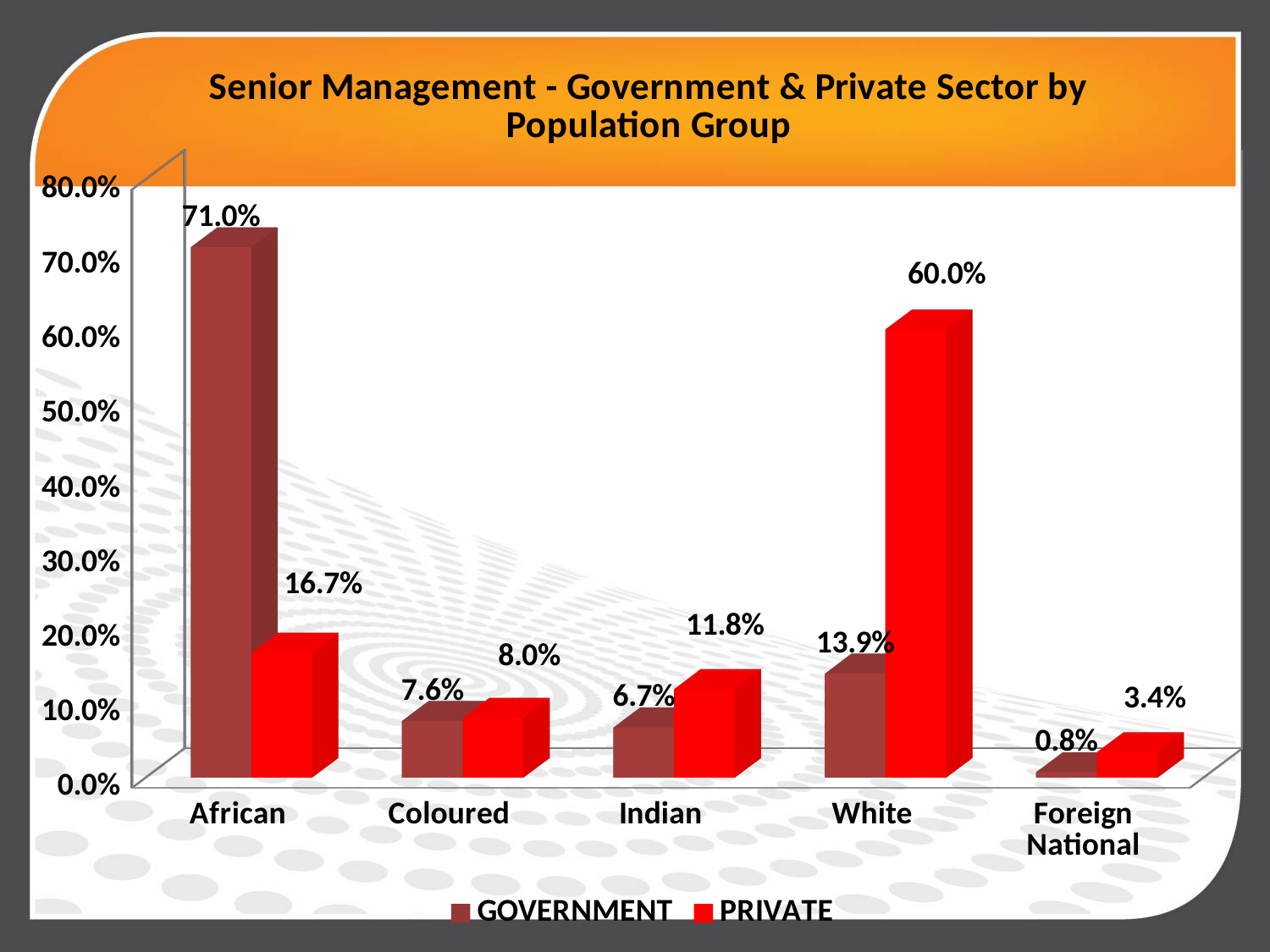
Which population group has the highest GOVERNMENT value? African How many series does the legend list? 2 What is the GOVERNMENT value for African? 71.0% What kind of chart is shown on the slide? Bar chart Which is larger for White: the GOVERNMENT value or the PRIVATE value? PRIVATE What is the title of the chart? Senior Management - Government & Private Sector by Population Group What is the PRIVATE value for White? 60.0% Which population group has the lowest PRIVATE value? Foreign National How many population groups are shown on the x axis? 5 What is the PRIVATE value for Foreign National? 3.4% What is the difference between the GOVERNMENT and PRIVATE values for African? 54.3% What is the GOVERNMENT value for Indian? 6.7%